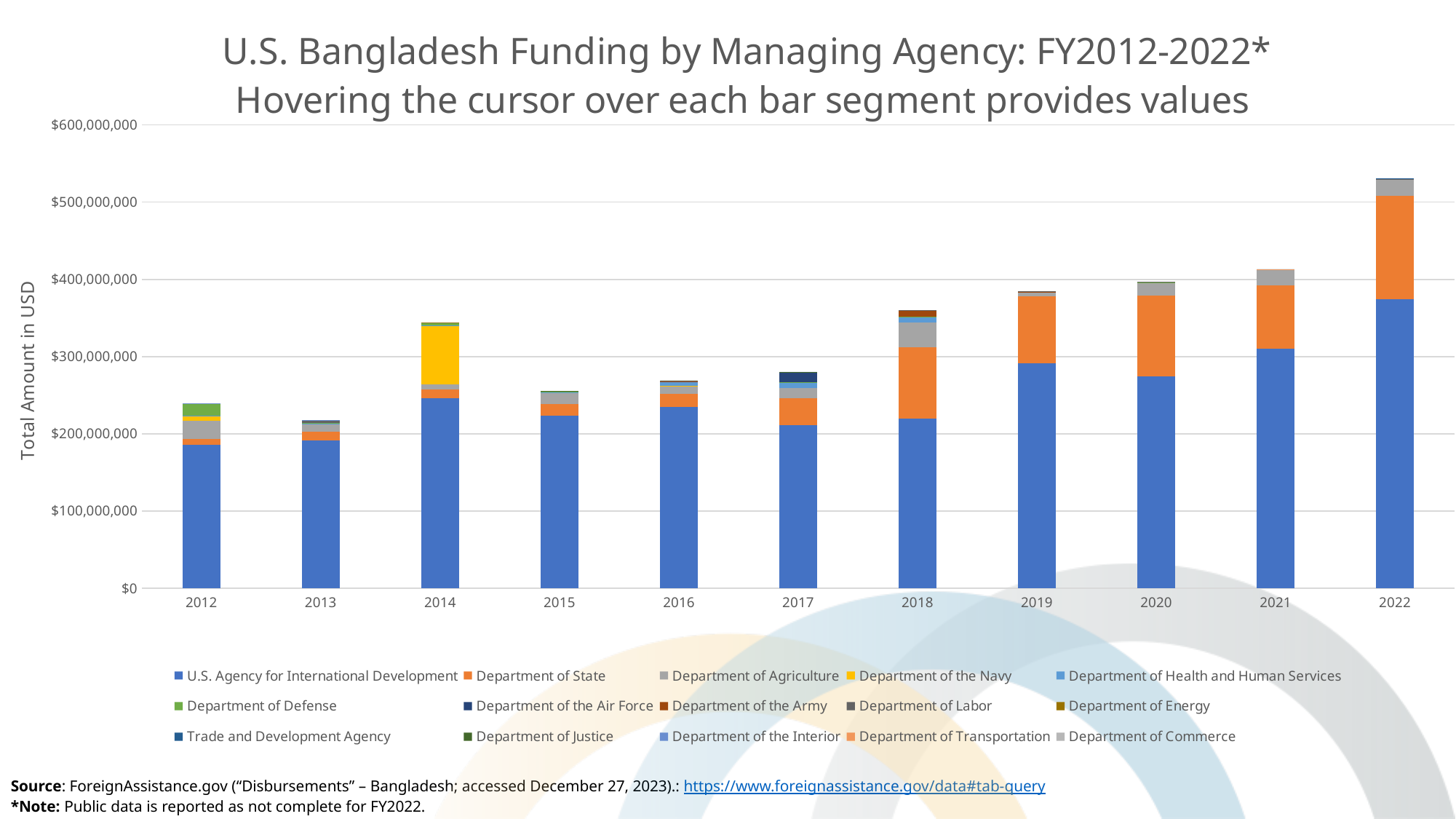
Is the total funding for 2021 greater or less than $400,000,000? greater Is the total funding for 2022 greater or less than $500,000,000? greater Which year has the lowest total funding? 2013 In which year does the Department of the Navy segment appear in the chart? 2012 and 2014 How many fiscal years are plotted along the x axis? 11 Do the total funding amounts rise or fall from 2018 to 2022? rise Is the total funding for 2019 greater or less than $400,000,000? less How many managing agencies does the legend list? 15 What kind of chart is shown on the slide? Stacked bar chart Which year has the larger total funding, 2017 or 2018? 2018 Which year has the highest total funding? 2022